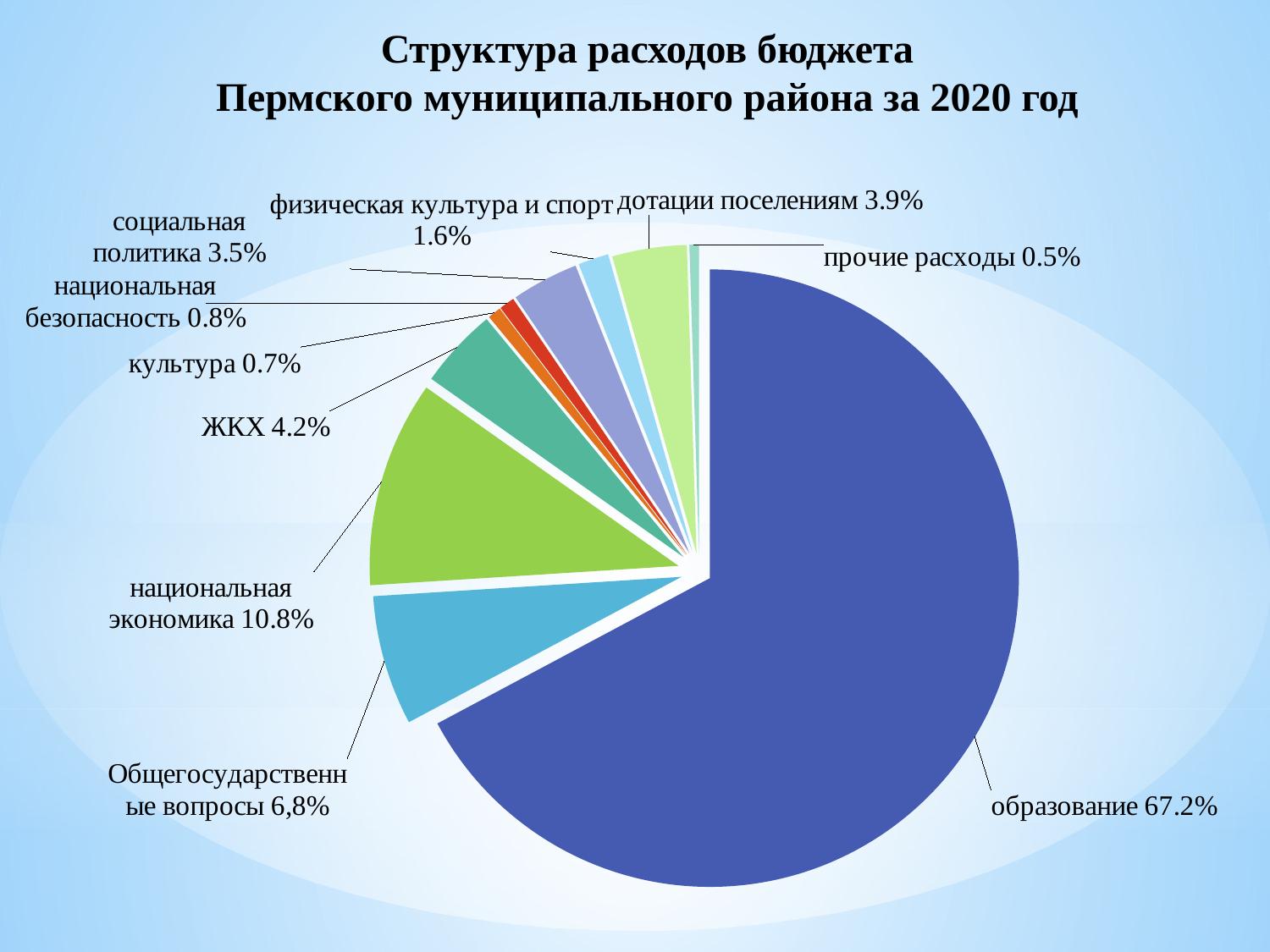
Which category has the largest slice of the pie? образование Which is larger, социальная политика or физическая культура и спорт? социальная политика What share of budget expenditure does образование account for? 67.2% What is the title of the chart? Структура расходов бюджета Пермского муниципального района за 2020 год Which category has the smallest slice of the pie? прочие расходы What is the value shown for национальная экономика? 10.8% What percentage is shown for ЖКХ? 4.2% What type of chart is shown on the slide? pie chart What share is shown for Общегосударственные вопросы? 6,8% What is the value for дотации поселениям? 3.9% What is the difference between the shares of образование and национальная экономика? 56.4% How many categories are shown in the pie chart? 10